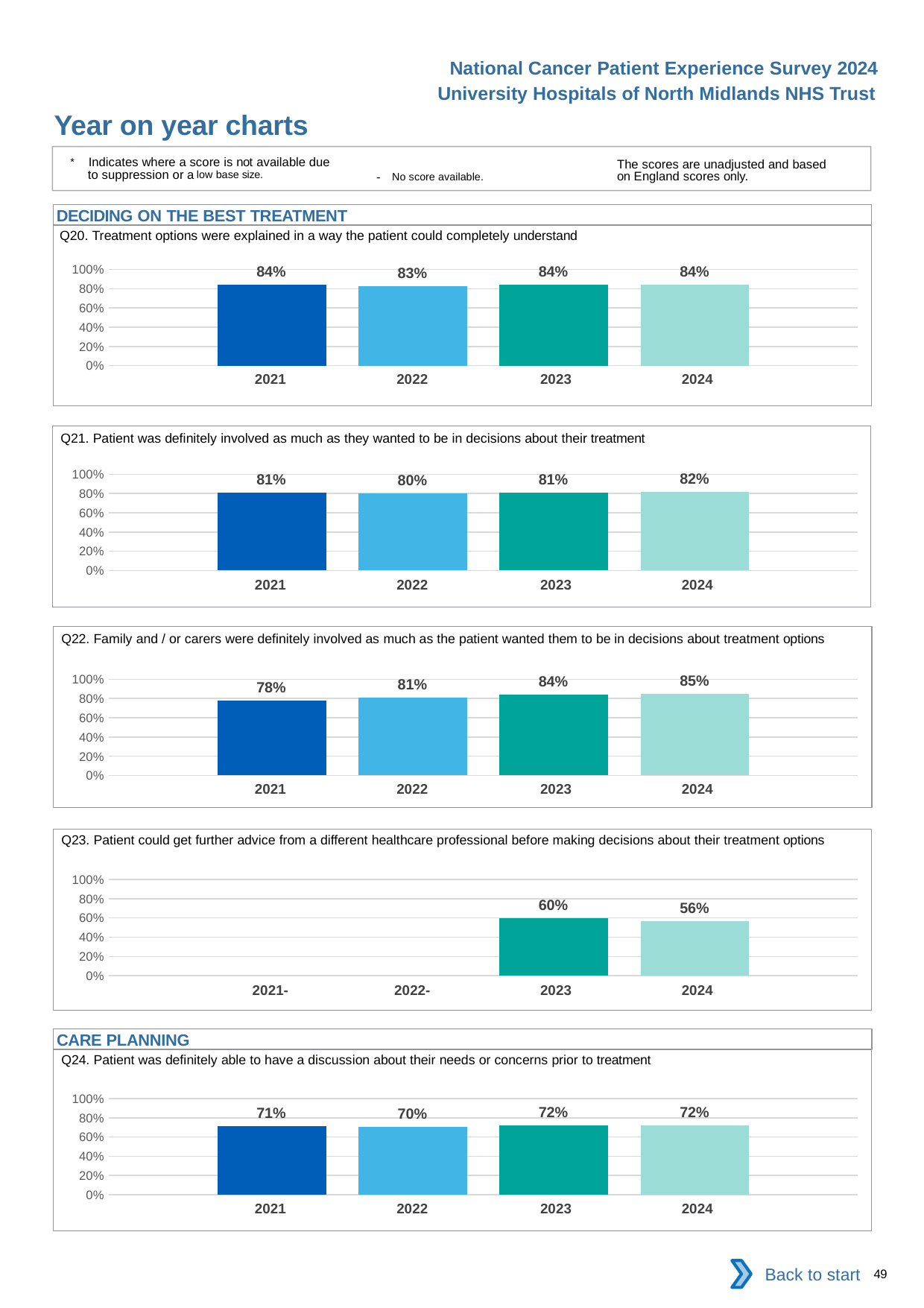
In the Q23 chart, which is larger, the value for 2023 or 2024? 2023 In the Q21 chart, which year has the highest value? 2024 In the Q22 chart, what is the difference between the 2024 and 2021 values? 7 percentage points In the Q23 chart, how many years have a bar plotted? 2 In the Q24 chart, which year has the lowest value? 2022 What kind of chart is the Q20 chart? bar chart In the Q20 chart, what is the value for 2022? 83% In the Q24 chart, is the value for 2023 greater or less than 60%? greater In the Q22 chart, do the values rise or fall from 2021 to 2024? rise In the Q23 chart, what is the value for 2023? 60% In the Q24 chart, what is the value for 2021? 71% In the Q21 chart, what is the difference between the 2024 and 2022 values? 2 percentage points